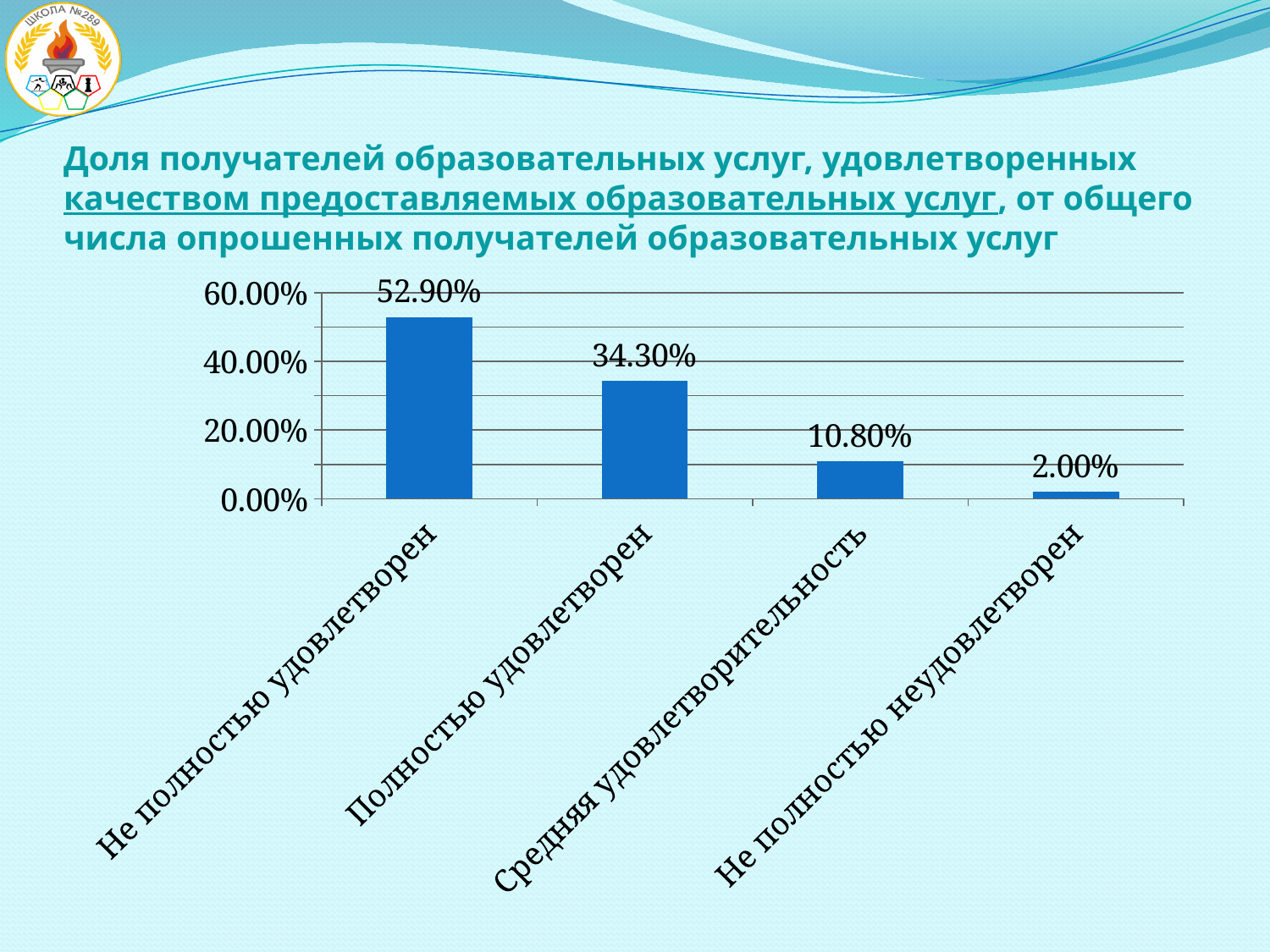
What is the value for "Средняя удовлетворительность"? 10.80% What is the value for "Полностью удовлетворен"? 34.30% What kind of chart is shown on the slide? Bar chart What is the value for "Не полностью удовлетворен"? 52.90% What is the value for "Не полностью неудовлетворен"? 2.00% What is the difference between the values for "Не полностью удовлетворен" and "Полностью удовлетворен"? 18.60% Which category has the highest value? Не полностью удовлетворен Is the value for "Не полностью удовлетворен" greater or less than 40.00%? greater How many categories are shown on the chart? 4 Do the values rise or fall from left to right along the x axis? Fall Which category has the lowest value? Не полностью неудовлетворен Which is larger: the value for "Полностью удовлетворен" or for "Средняя удовлетворительность"? Полностью удовлетворен